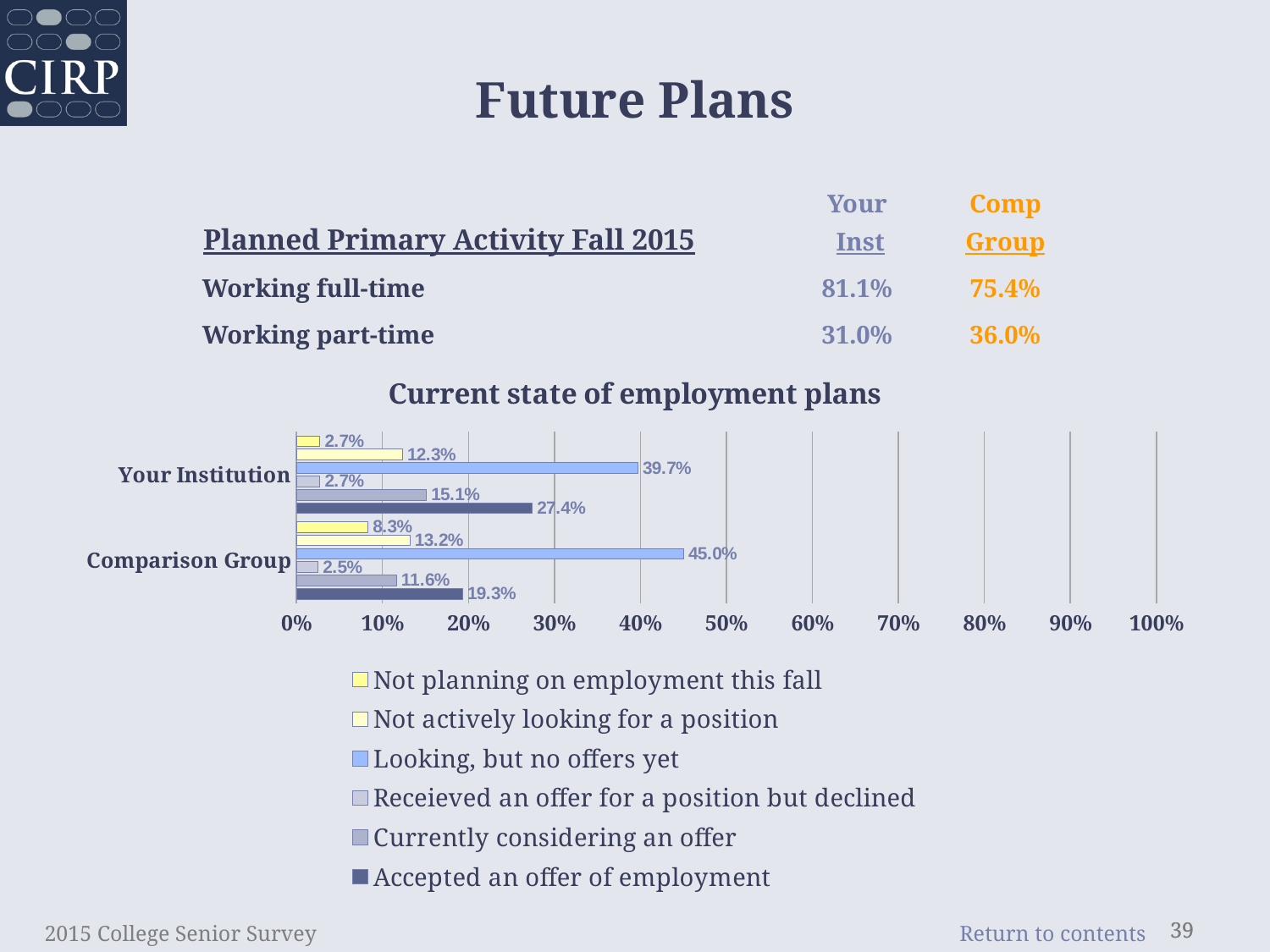
In the "Current state of employment plans" chart, what is the value for "Currently considering an offer" for Your Institution? 15.1% In the "Current state of employment plans" chart, which series has the lowest value for the Comparison Group? Receieved an offer for a position but declined In the "Current state of employment plans" chart, what is the value for "Not planning on employment this fall" for the Comparison Group? 8.3% In the "Current state of employment plans" chart, what is the value for "Looking, but no offers yet" for Your Institution? 39.7% How many categories are plotted on the y axis of the "Current state of employment plans" chart? 2 What kind of chart is shown under "Current state of employment plans"? bar chart In the "Current state of employment plans" chart, what is the value for "Accepted an offer of employment" for the Comparison Group? 19.3% How many series does the legend of the "Current state of employment plans" chart list? 6 In the "Current state of employment plans" chart, what is the difference between the "Accepted an offer of employment" values for Your Institution and the Comparison Group? 8.1% In the "Current state of employment plans" chart, which is larger: "Looking, but no offers yet" for Your Institution or for the Comparison Group? Comparison Group In the "Current state of employment plans" chart, which series has the highest value for the Comparison Group? Looking, but no offers yet In the "Current state of employment plans" chart, what colour is the "Accepted an offer of employment" series? dark blue